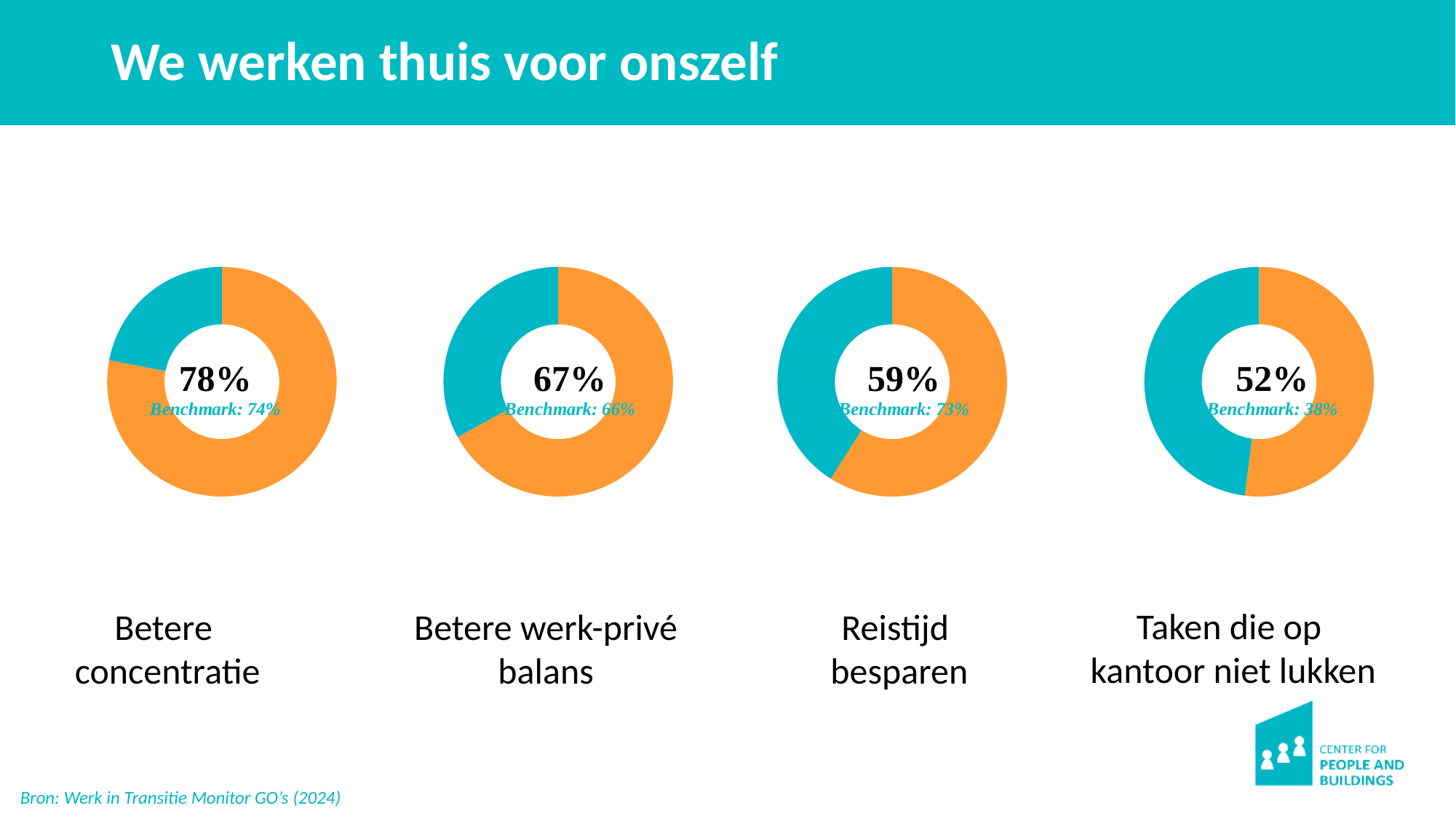
Which of the four donut charts shows the lowest main percentage? Taken die op kantoor niet lukken What type of chart is used for each of the four figures on the slide? Donut (pie) chart What benchmark value is printed in the 'Reistijd besparen' donut chart? 73% What percentage is shown in the centre of the 'Betere concentratie' donut chart? 78% How many donut charts are shown on the slide? 4 What percentage is shown in the centre of the 'Reistijd besparen' donut chart? 59% What percentage is shown in the centre of the 'Betere werk-privé balans' donut chart? 67% What percentage is shown in the centre of the 'Taken die op kantoor niet lukken' donut chart? 52% In the 'Reistijd besparen' chart, which is larger: the main percentage or the benchmark? The benchmark (73%) Which of the four donut charts shows the highest main percentage? Betere concentratie In the 'Taken die op kantoor niet lukken' chart, what is the difference between the main percentage and the benchmark? 14 percentage points What benchmark value is printed in the 'Taken die op kantoor niet lukken' donut chart? 38%